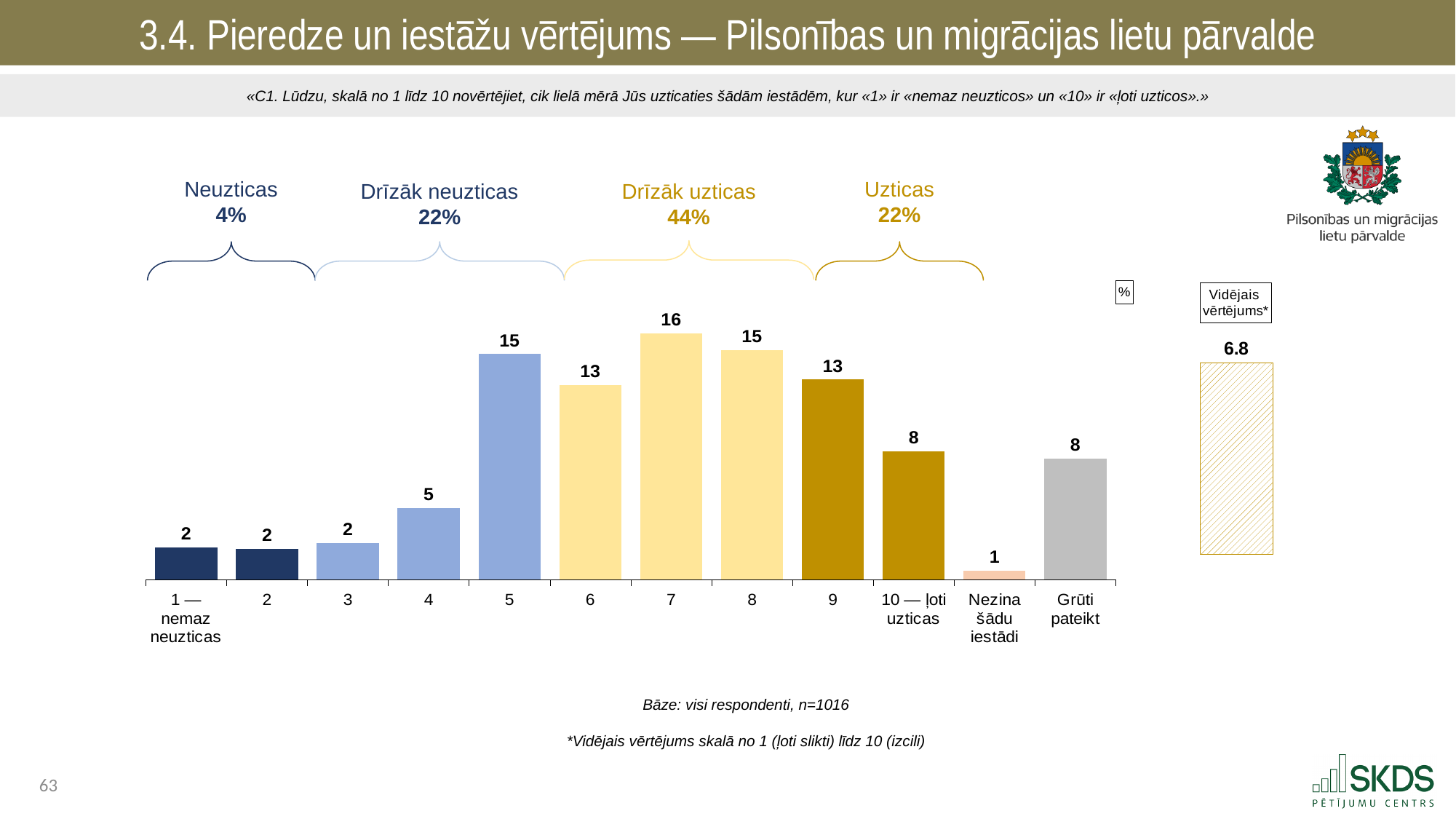
Which rating category has the highest value in the chart? 7 What is the average rating (Vidējais vērtējums) shown on the slide? 6.8 Which is larger, the value for rating 6 or the value for rating 8? rating 8 Which category has the lowest value in the chart? Nezina šādu iestādi How many categories are shown on the x axis of the chart? 12 What is the value for the rating "10 — ļoti uzticas"? 8 What percentage of respondents gave a rating of 7? 16 What share of respondents falls into the "Drīzāk uzticas" group? 44% What is the value for the category "Grūti pateikt"? 8 What kind of chart is shown on the slide? bar chart What is the combined value of the "Neuzticas" and "Drīzāk neuzticas" groups shown above the chart? 26% What is the difference between the value for rating 5 and the value for rating 4? 10